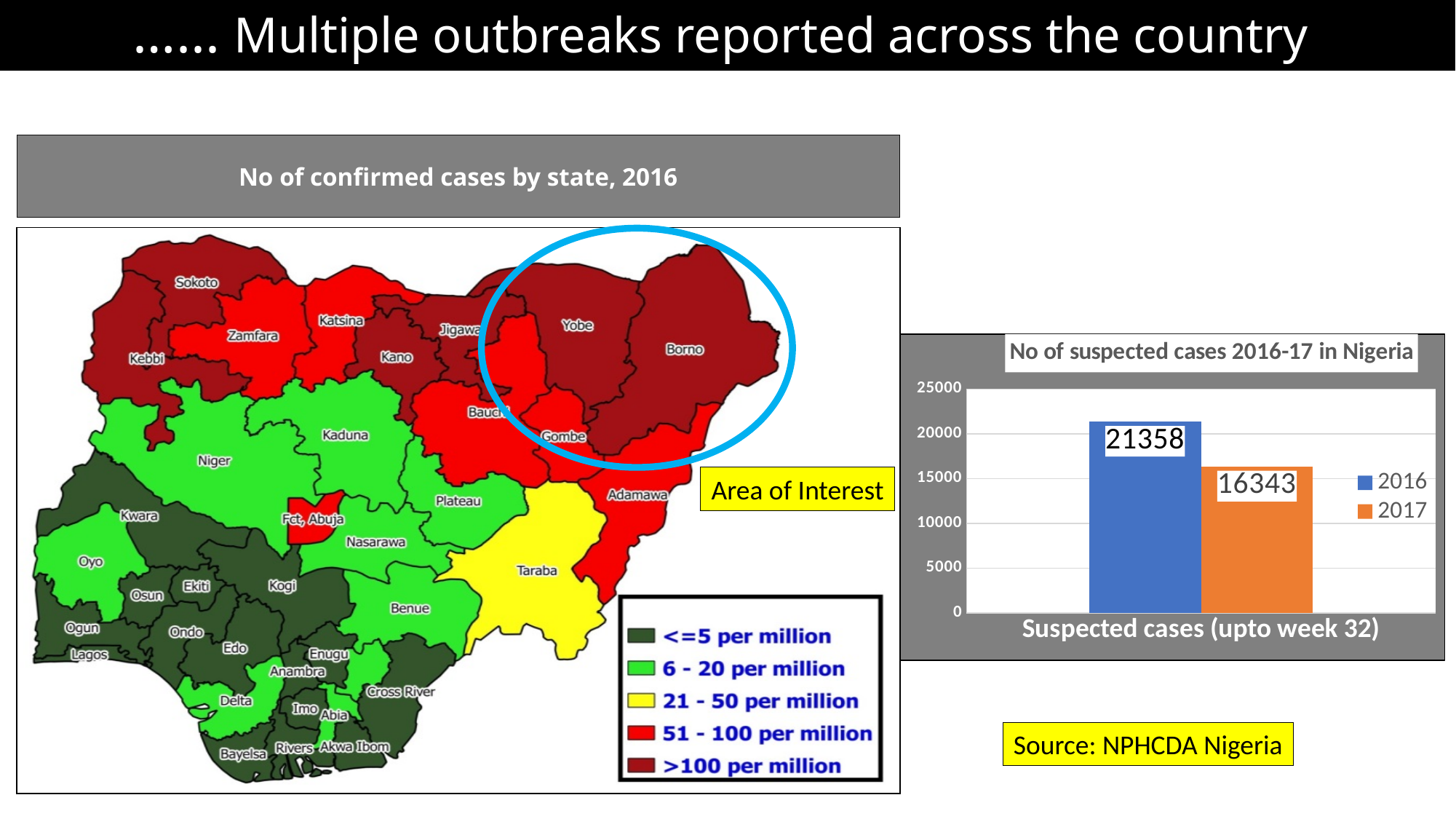
In the chart 'No of suspected cases 2016-17 in Nigeria', what is the label on the x axis? Suspected cases (upto week 32) In the chart 'No of suspected cases 2016-17 in Nigeria', what is the difference between the 2016 and 2017 values? 5015 In the chart 'No of suspected cases 2016-17 in Nigeria', which year has the lower number of suspected cases? 2017 In the chart 'No of suspected cases 2016-17 in Nigeria', what is the value for 2017? 16343 In the chart 'No of suspected cases 2016-17 in Nigeria', is the value for 2017 larger or smaller than the value for 2016? smaller What kind of chart is 'No of suspected cases 2016-17 in Nigeria'? bar chart How many series does the legend of the chart 'No of suspected cases 2016-17 in Nigeria' list? 2 In the chart 'No of suspected cases 2016-17 in Nigeria', is the value for 2016 greater or less than 20000? greater In the chart 'No of suspected cases 2016-17 in Nigeria', what is the value for 2016? 21358 In the chart 'No of suspected cases 2016-17 in Nigeria', is the value for 2017 greater or less than 15000? greater In the chart 'No of suspected cases 2016-17 in Nigeria', which year has the higher number of suspected cases? 2016 In the chart 'No of suspected cases 2016-17 in Nigeria', what colour is the bar for 2017? orange